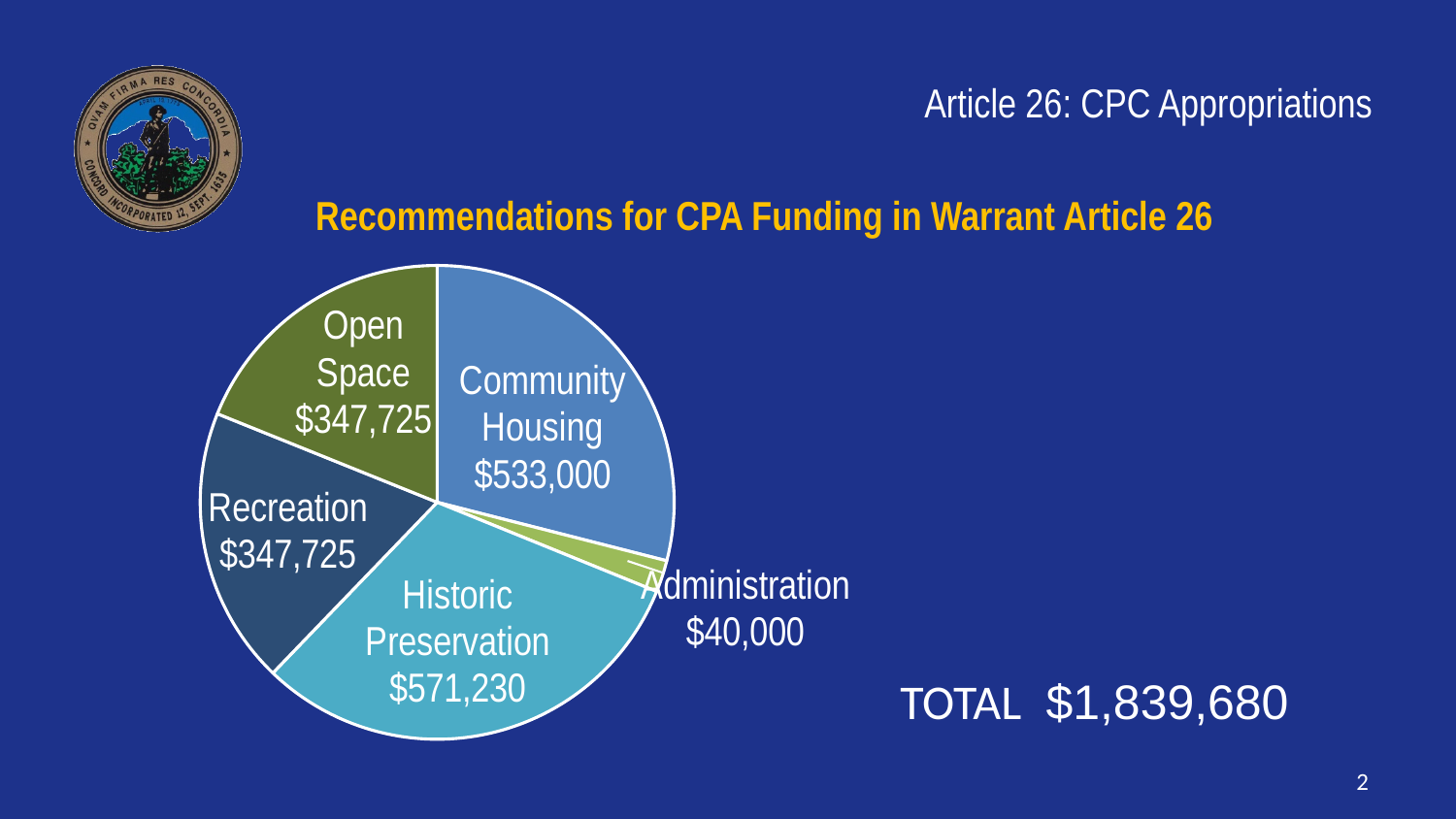
What is the difference between the Open Space and Administration amounts? $307,725 How many categories are shown in the pie chart? 5 What type of chart is shown on the slide? Pie chart What is the value for Community Housing in the pie chart? $533,000 What is the total of all the amounts shown in the pie chart? $1,839,680 Which category receives the largest amount in the pie chart? Historic Preservation What is the value for Historic Preservation in the pie chart? $571,230 How much more is allocated to Historic Preservation than to Community Housing? $38,230 What is the value for Recreation in the pie chart? $347,725 What is the value for Administration in the pie chart? $40,000 Which is larger, the amount for Community Housing or the amount for Historic Preservation? Historic Preservation Which category receives the smallest amount in the pie chart? Administration